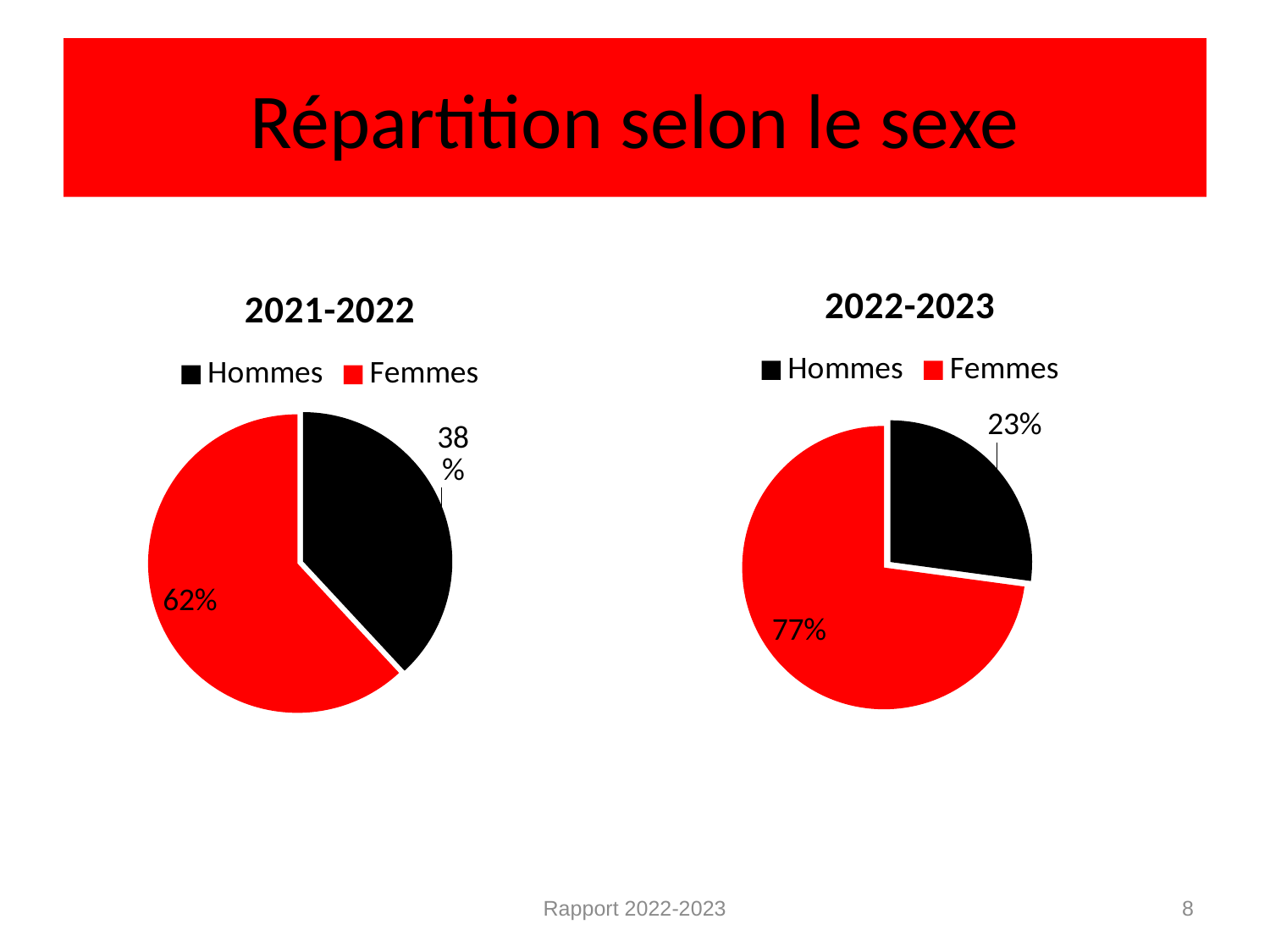
In the 2021-2022 chart, what is the difference between the Femmes and Hommes shares? 24% How many categories does the 2021-2022 chart show? 2 In the 2021-2022 chart, what share of the pie is Femmes? 62% In the 2022-2023 chart, what colour is the Femmes slice? Red In the 2022-2023 chart, what is the difference between the Femmes and Hommes shares? 54% In the 2021-2022 chart, what share of the pie is Hommes? 38% In the 2022-2023 chart, which category has the smallest slice? Hommes Is the Hommes share larger in the 2021-2022 chart or the 2022-2023 chart? 2021-2022 In the 2021-2022 chart, which category has the largest slice? Femmes What kind of chart is the 2022-2023 chart? Pie chart In the 2022-2023 chart, what share of the pie is Femmes? 77%